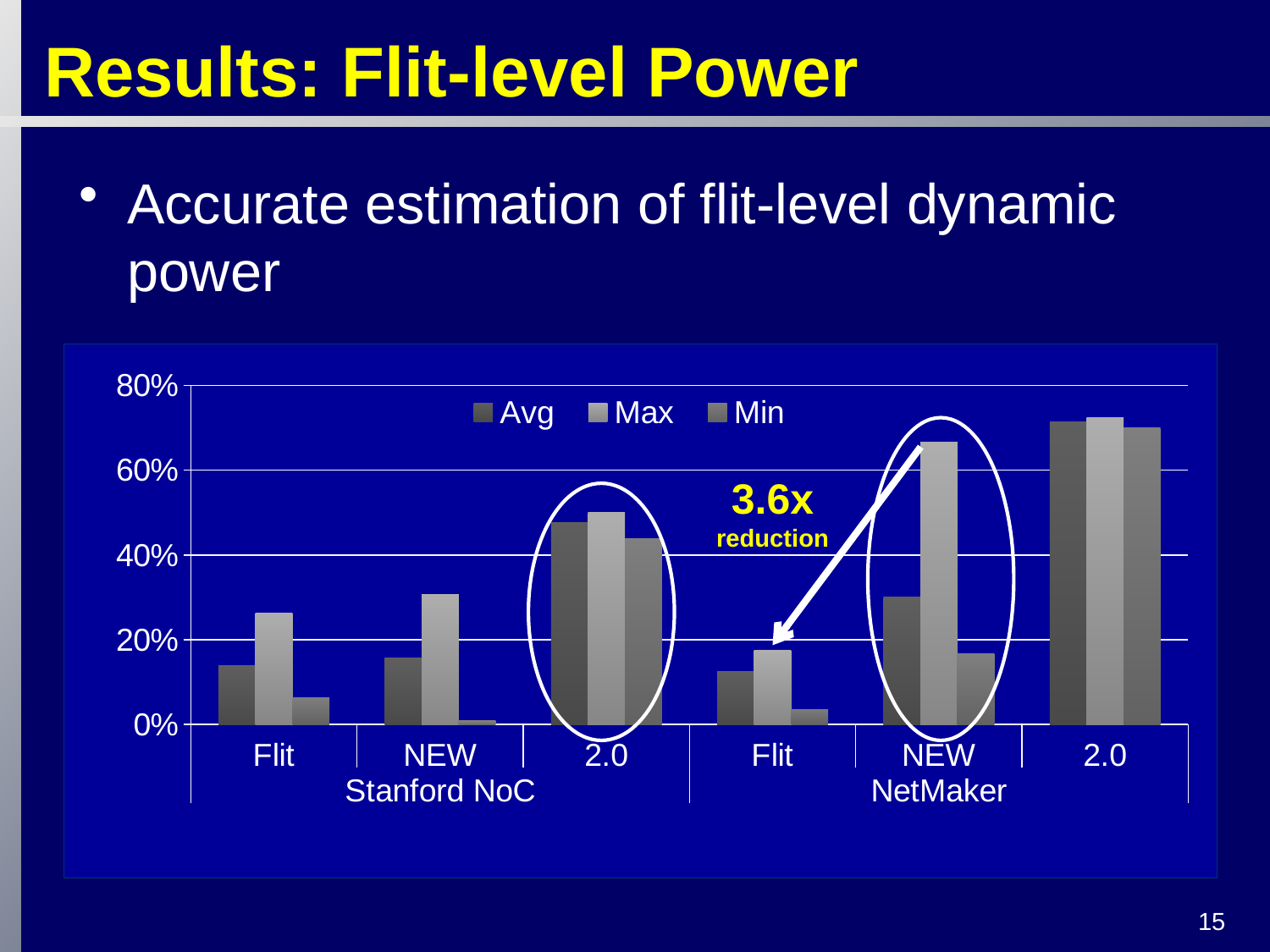
Is the Min value for 2.0 under Stanford NoC greater or less than 40%? greater What are the three series named in the legend? Avg, Max, Min Is the Avg value for Flit under Stanford NoC greater or less than 20%? less Is the Max value for NEW under Stanford NoC greater or less than 40%? less What annotation text is written between the two circled groups of bars? 3.6x reduction Which is larger: the Max value for 2.0 under Stanford NoC or the Max value for NEW under NetMaker? NEW under NetMaker What kind of chart is shown on the slide? bar chart Which category has the highest Avg value? 2.0 under NetMaker How many series does the legend list? 3 How many category groups are plotted along the x axis? 6